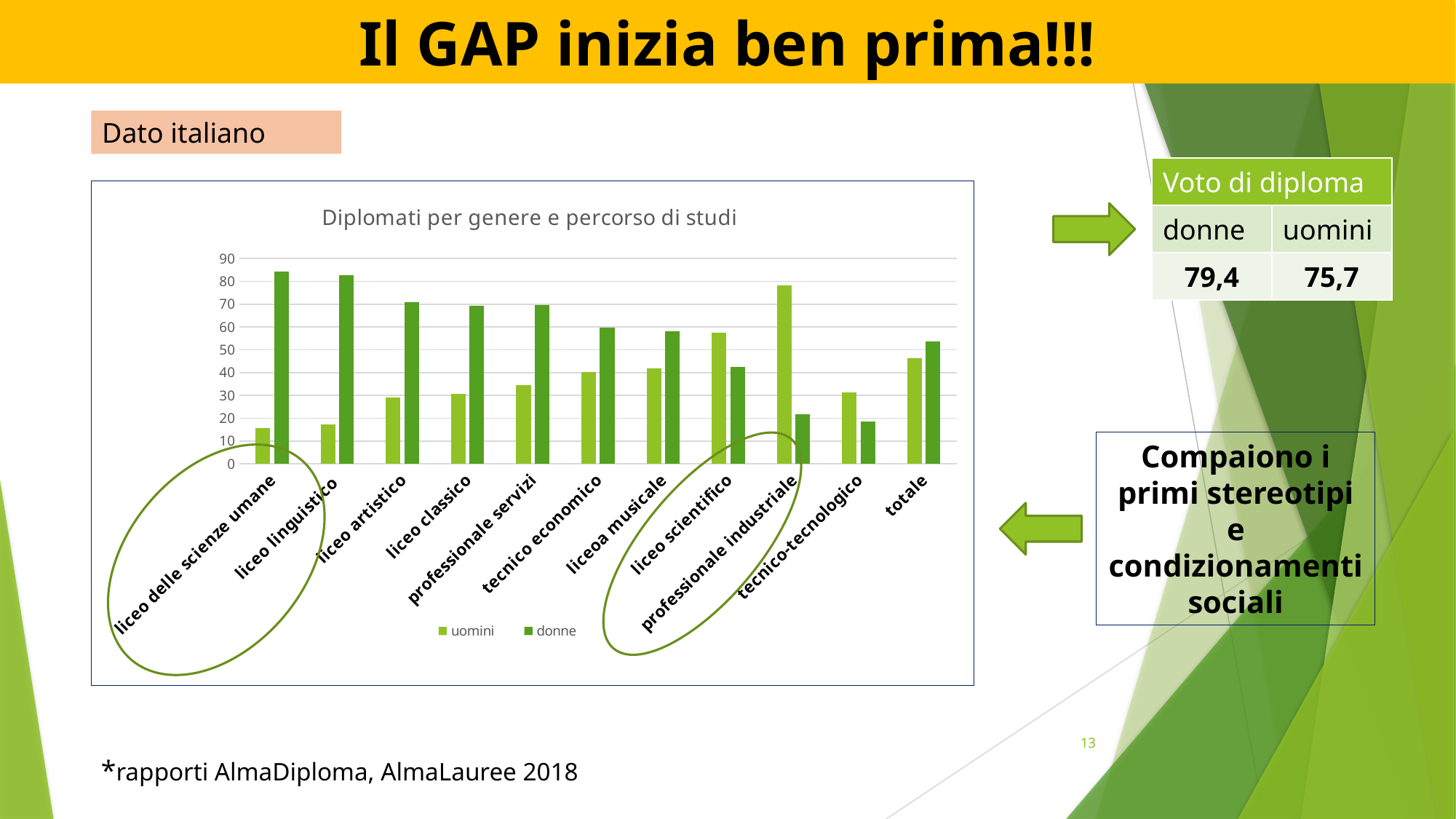
For liceo classico, which series has the larger value, uomini or donne? donne Is the value for uomini in liceo delle scienze umane greater or less than 20? less What kind of chart is shown on the slide? bar chart Which category has the highest value for uomini? professionale industriale For liceo scientifico, which series has the larger value, uomini or donne? uomini What is the title of the chart? Diplomati per genere e percorso di studi Which two series are listed in the chart legend? uomini and donne Is the value for uomini in professionale industriale greater or less than 70? greater Is the value for donne in liceo delle scienze umane greater or less than 80? greater How many series does the chart legend list? 2 How many categories are shown on the x axis of the chart? 11